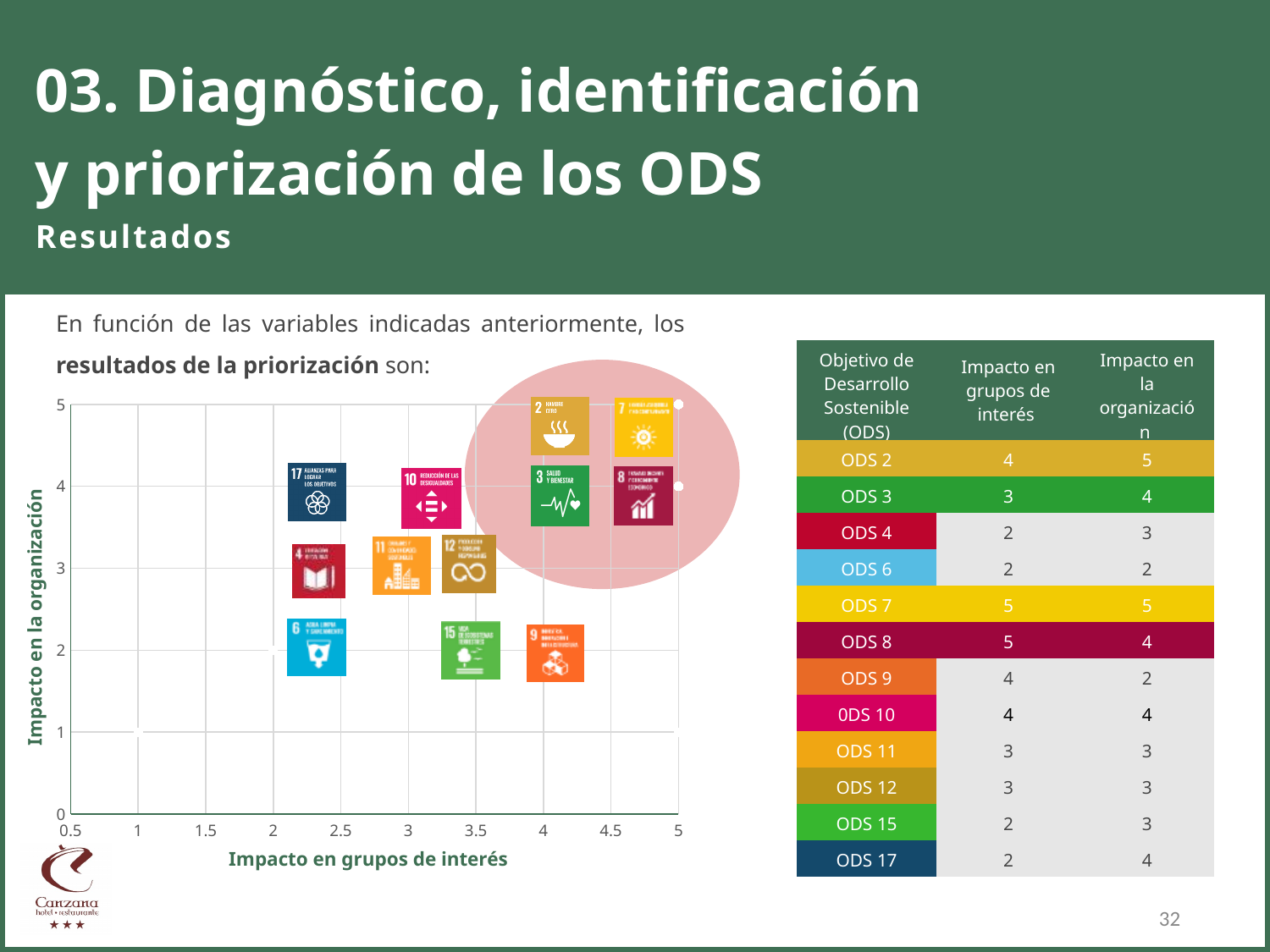
Which has a higher 'Impacto en grupos de interés' value in the chart, ODS 9 or ODS 6? ODS 9 What is the 'Impacto en la organización' value for ODS 8 in the chart? 4 Is the 'Impacto en la organización' value for ODS 9 greater or less than 3? less What is the title of the vertical axis of the chart? Impacto en la organización Is the 'Impacto en la organización' value for ODS 6 greater or less than 3? less How many ODS icons are plotted in the chart? 12 Is the 'Impacto en grupos de interés' value for ODS 17 greater or less than 3? less How many ODS icons are inside the shaded pink ellipse on the chart? 4 Which ODS is plotted at the top-right corner of the chart, with the highest values on both axes? ODS 7 What is the title of the horizontal axis of the chart? Impacto en grupos de interés What kind of chart is shown on the slide? scatter chart What is the 'Impacto en grupos de interés' value for ODS 7 in the chart? 5